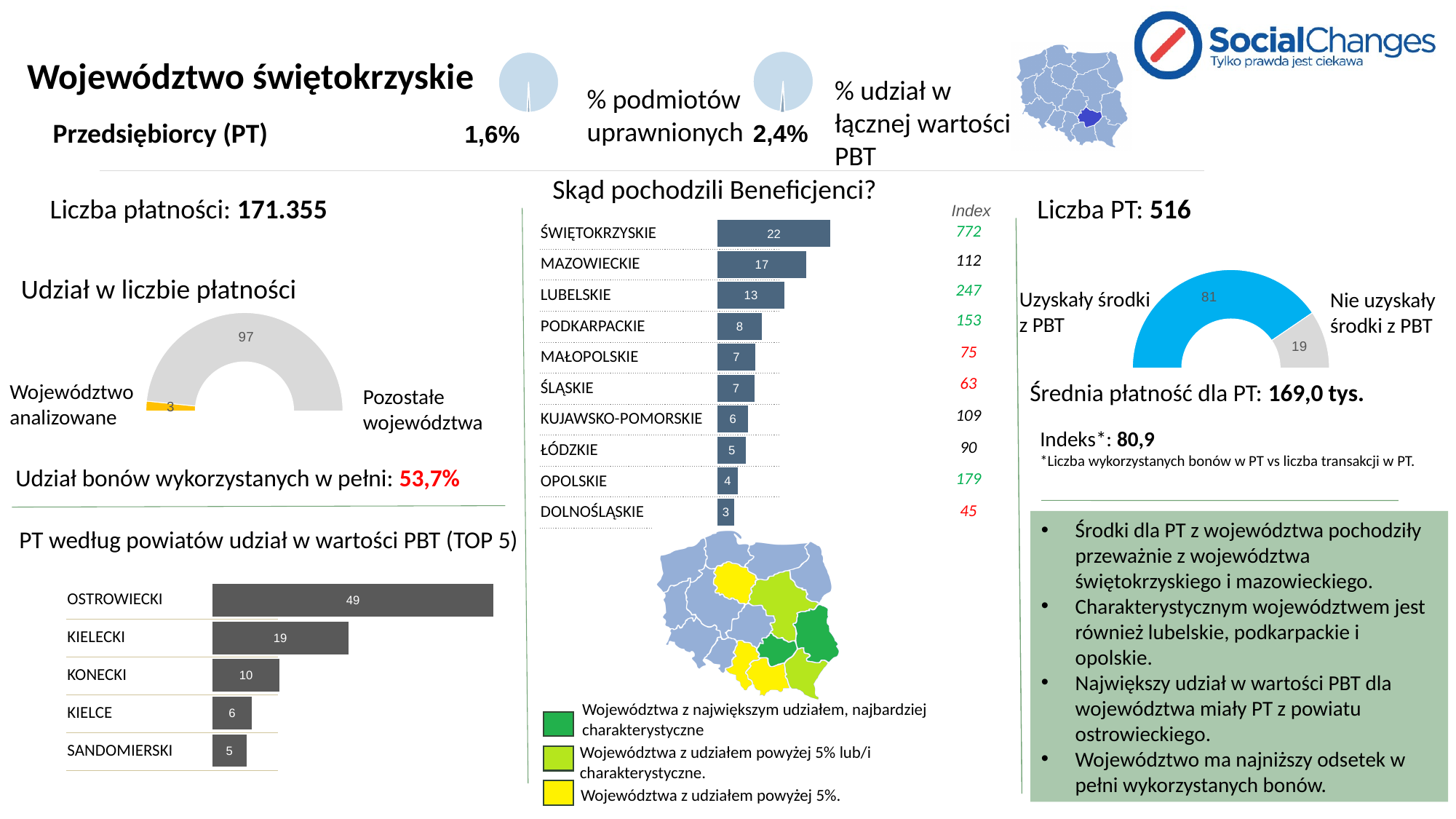
In the 'PT według powiatów udział w wartości PBT (TOP 5)' chart, what is the value for KIELECKI? 19 In the 'PT według powiatów udział w wartości PBT (TOP 5)' chart, which is larger, KONECKI or SANDOMIERSKI? KONECKI In the 'Skąd pochodzili Beneficjenci?' chart, what Index value is shown next to OPOLSKIE? 179 In the 'Skąd pochodzili Beneficjenci?' chart, how many voivodeships are listed? 10 In the 'Skąd pochodzili Beneficjenci?' chart, which voivodeship has the lowest value? DOLNOŚLĄSKIE In the 'Liczba PT' chart, what is the value for 'Nie uzyskały środki z PBT'? 19 In the 'Skąd pochodzili Beneficjenci?' chart, what is the value for MAZOWIECKIE? 17 In the 'PT według powiatów udział w wartości PBT (TOP 5)' chart, which powiat has the highest value? OSTROWIECKI In the 'Udział w liczbie płatności' chart, what is the value for 'Województwo analizowane'? 3 In the 'PT według powiatów udział w wartości PBT (TOP 5)' chart, what is the difference between OSTROWIECKI and KIELECKI? 30 In the 'Skąd pochodzili Beneficjenci?' chart, which voivodeship has the highest value? ŚWIĘTOKRZYSKIE In the 'Skąd pochodzili Beneficjenci?' chart, what is the difference between the values for ŚWIĘTOKRZYSKIE and LUBELSKIE? 9